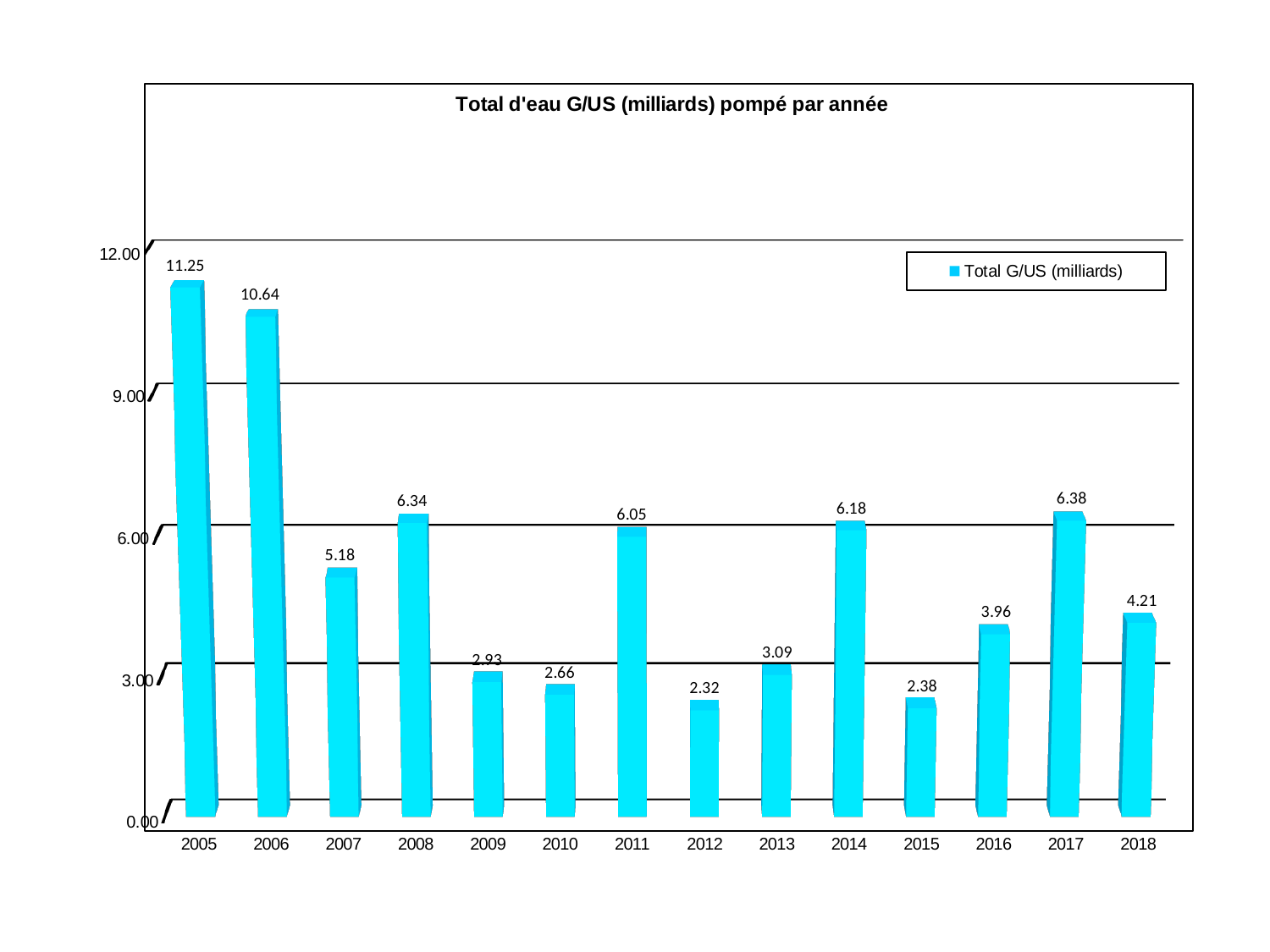
Which year has the lowest value? 2012 Which is larger, the value for 2011 or the value for 2013? 2011 Which year has the highest value? 2005 How many series does the legend list? 1 What is the value for 2012? 2.32 What is the difference between the values for 2005 and 2006? 0.61 What is the value for 2005? 11.25 What type of chart is shown on the slide? bar chart What is the value for 2017? 6.38 What is the title of the chart? Total d'eau G/US (milliards) pompé par année What is the difference between the values for 2018 and 2016? 0.25 How many years are shown on the x axis? 14